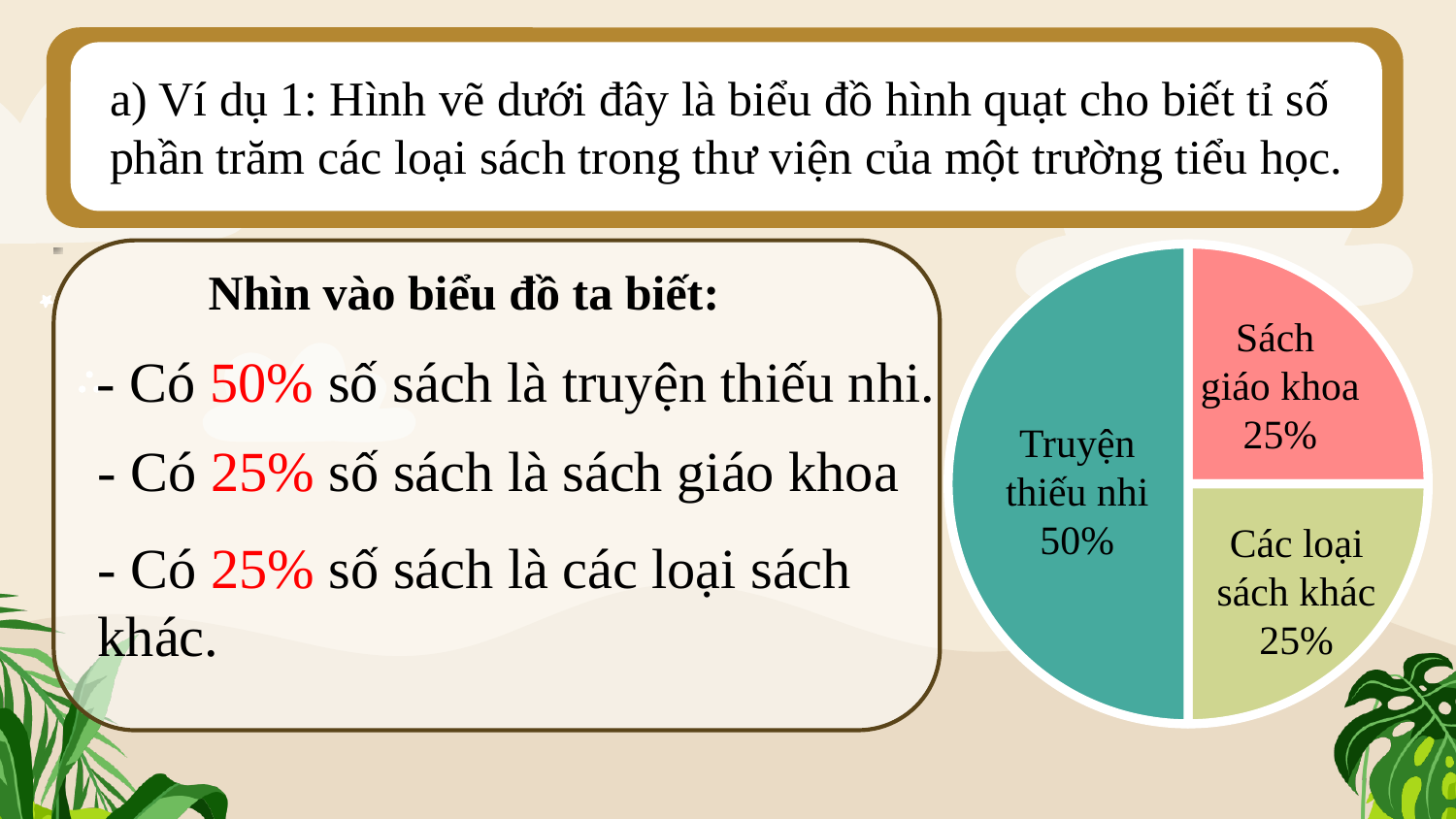
What is the difference between the "Truyện thiếu nhi" slice and the "Các loại sách khác" slice in the pie chart? 25% What value is shown for the "Các loại sách khác" slice of the pie chart? 25% Which slice of the pie chart is coloured pink? Sách giáo khoa What do the "Sách giáo khoa" and "Các loại sách khác" slices add up to in the pie chart? 50% What value is shown for the "Sách giáo khoa" slice of the pie chart? 25% What share of the pie chart does "Truyện thiếu nhi" take up? 50% What percentage of the pie chart is labelled "Truyện thiếu nhi"? 50% What colour is the "Truyện thiếu nhi" slice in the pie chart? Teal Which is larger in the pie chart, "Truyện thiếu nhi" or "Sách giáo khoa"? Truyện thiếu nhi Which slice of the pie chart is the largest? Truyện thiếu nhi What kind of chart is shown on the slide? Pie chart How many slices does the pie chart have? 3